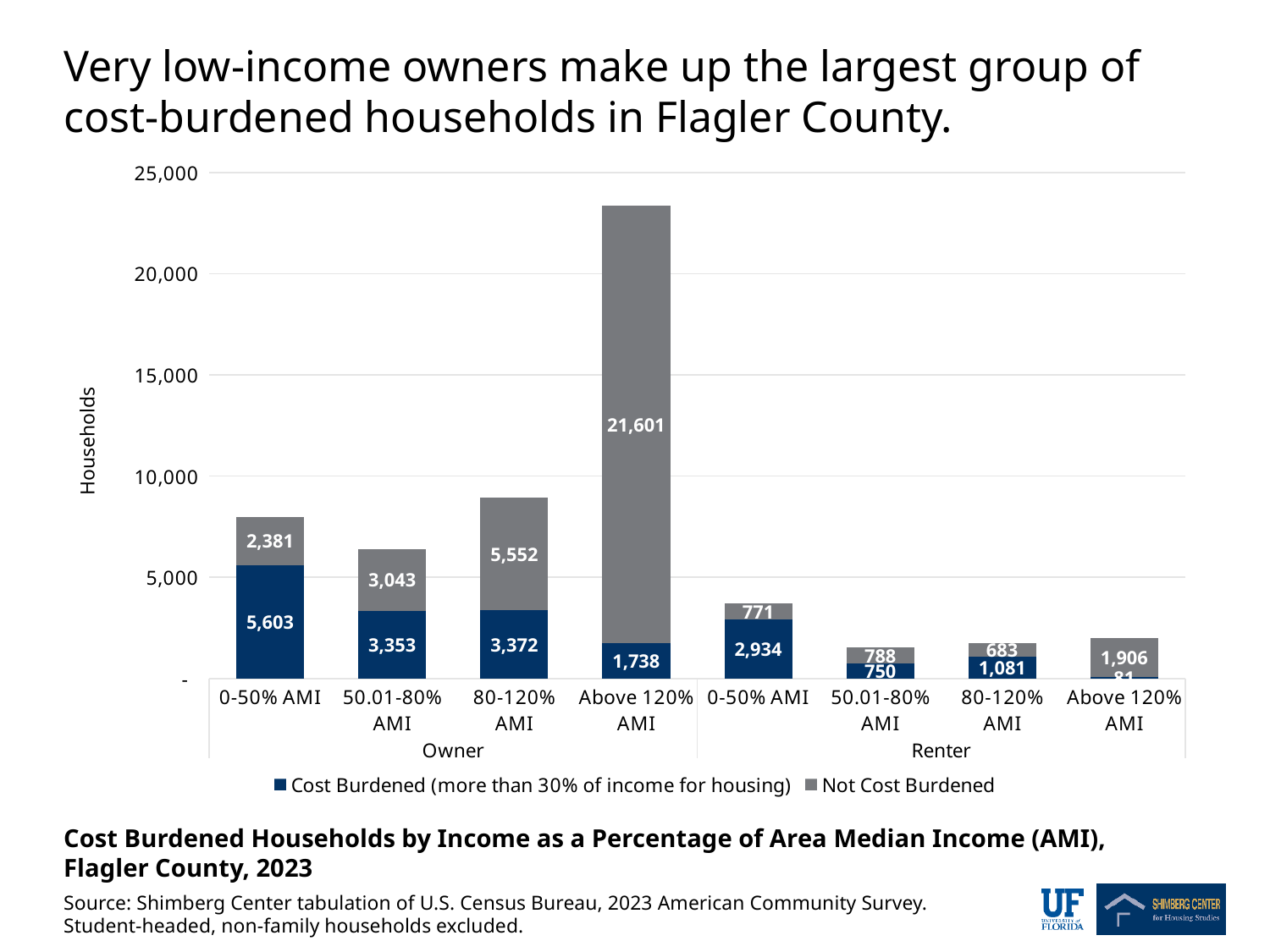
Which bar has the largest total number of households? Owner Above 120% AMI How many cost-burdened renter households are in the 80-120% AMI group? 1,081 What kind of chart is shown on the slide? Stacked bar chart How many not-cost-burdened owner households are in the Above 120% AMI group? 21,601 Which income group has the largest number of cost-burdened households? Owner 0-50% AMI Is the total height of the Owner Above 120% AMI bar greater or less than 20,000? greater Which is larger: the number of cost-burdened owner households at 50.01-80% AMI or the number of not-cost-burdened owner households at 50.01-80% AMI? Cost burdened (3,353) How many cost-burdened owner households are in the 0-50% AMI group? 5,603 How many income-group bars are plotted in total across Owner and Renter? 8 What is the total number of owner households in the 0-50% AMI group (cost burdened plus not cost burdened)? 7,984 How many series does the legend list? 2 What is the difference between cost-burdened owner households at 0-50% AMI and cost-burdened renter households at 0-50% AMI? 2,669